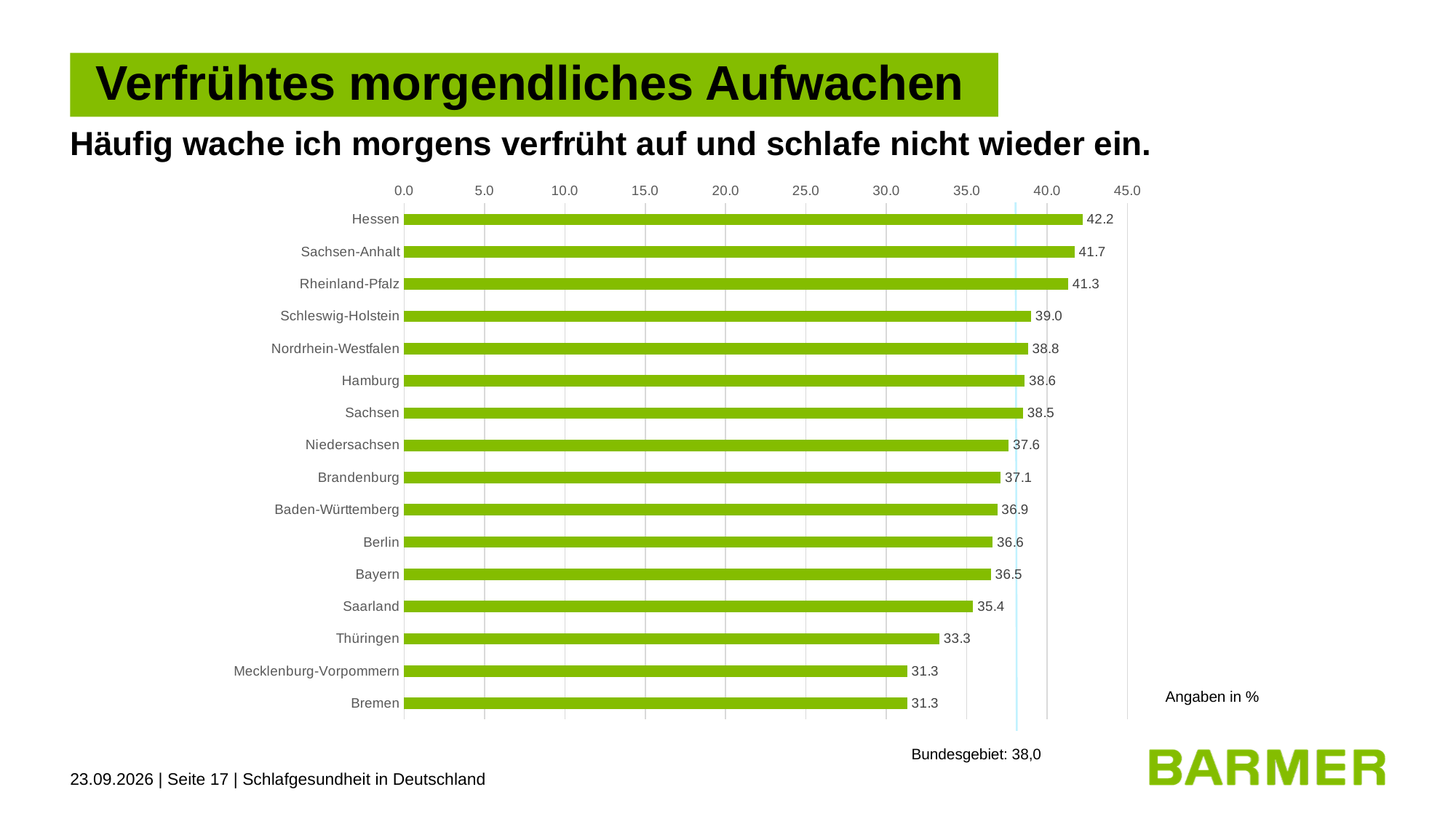
What is the difference between the values for Sachsen-Anhalt and Rheinland-Pfalz? 0.4 How many federal states are shown in the chart? 16 Which is larger, the value for Schleswig-Holstein or the value for Niedersachsen? Schleswig-Holstein Which federal state has the highest value? Hessen What is the value for Thüringen? 33.3 Is the value for Mecklenburg-Vorpommern greater or less than 35.0? less What kind of chart is shown on the slide? Bar chart What is the difference between the values for Hessen and Bremen? 10.9 What value is given for Bundesgebiet below the chart? 38,0 Is the value for Rheinland-Pfalz greater or less than 40.0? greater What is the value for Hessen? 42.2 What is the value for Saarland? 35.4